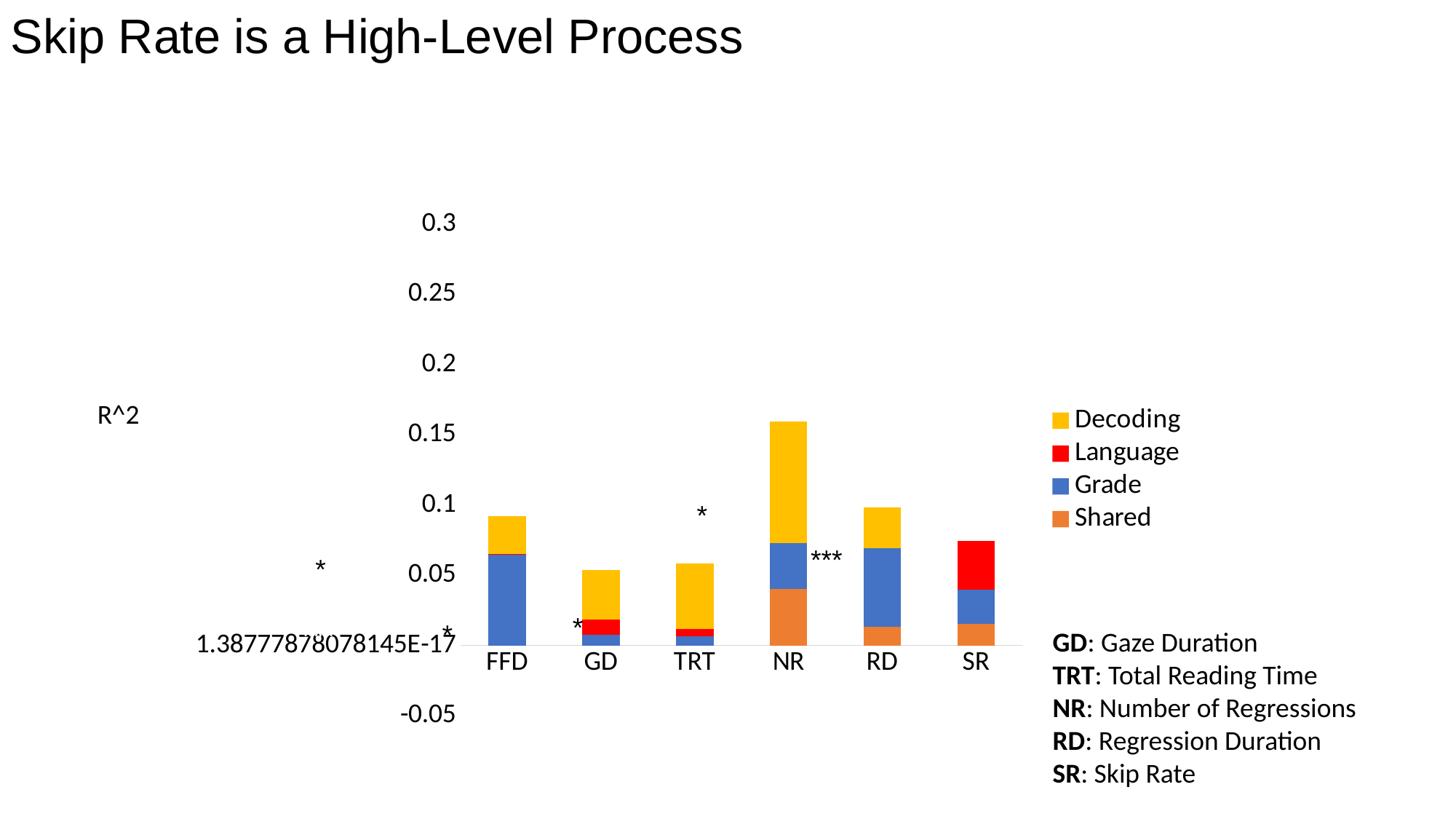
Is the total value for NR greater or less than 0.1? greater Is the total value for SR greater or less than 0.05? greater How many categories are shown on the x axis of the chart? 6 Is the total value for FFD greater or less than 0.1? less Which category has the largest Shared segment? NR Which category has the largest Language (red) segment? SR What kind of chart is shown on the slide? stacked bar chart Which category has the highest total stacked bar? NR Which has the larger total bar, NR or FFD? NR What label is shown on the y axis of the chart? R^2 How many series does the chart's legend list? 4